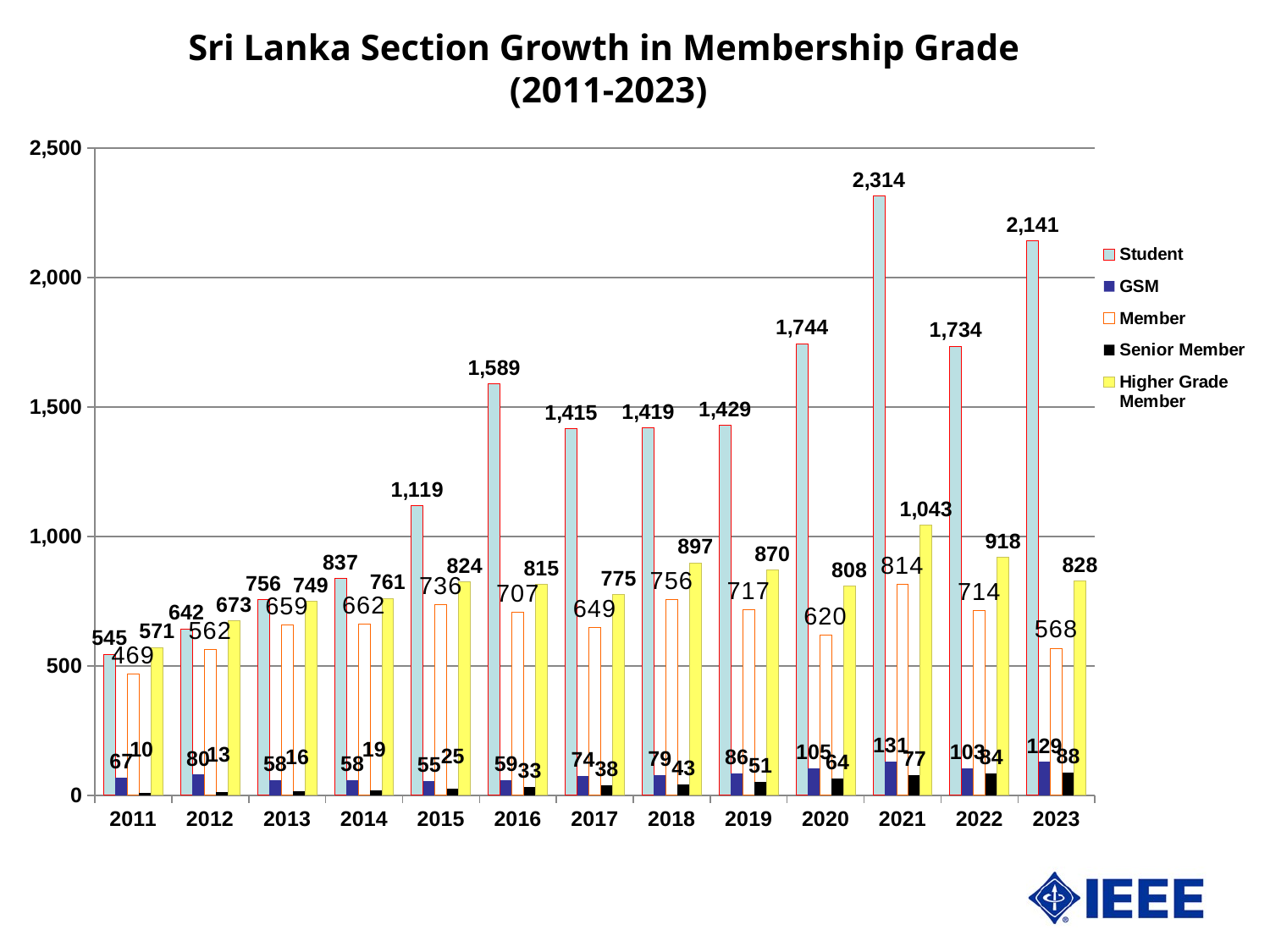
What is the difference between the Student values for 2021 and 2022? 580 What kind of chart is shown on the slide? Bar chart What is the Member value for 2013? 659 How many years are shown on the x axis? 13 Which year has the lowest Senior Member value? 2011 Which year has the highest Student value? 2021 What is the Senior Member value for 2023? 88 Do the Senior Member values rise or fall from 2011 to 2023? Rise What is the Student value for 2021? 2,314 Which is larger, the Member value for 2020 or the Higher Grade Member value for 2020? Higher Grade Member (808) What is the Higher Grade Member value for 2018? 897 How many series does the legend list? 5